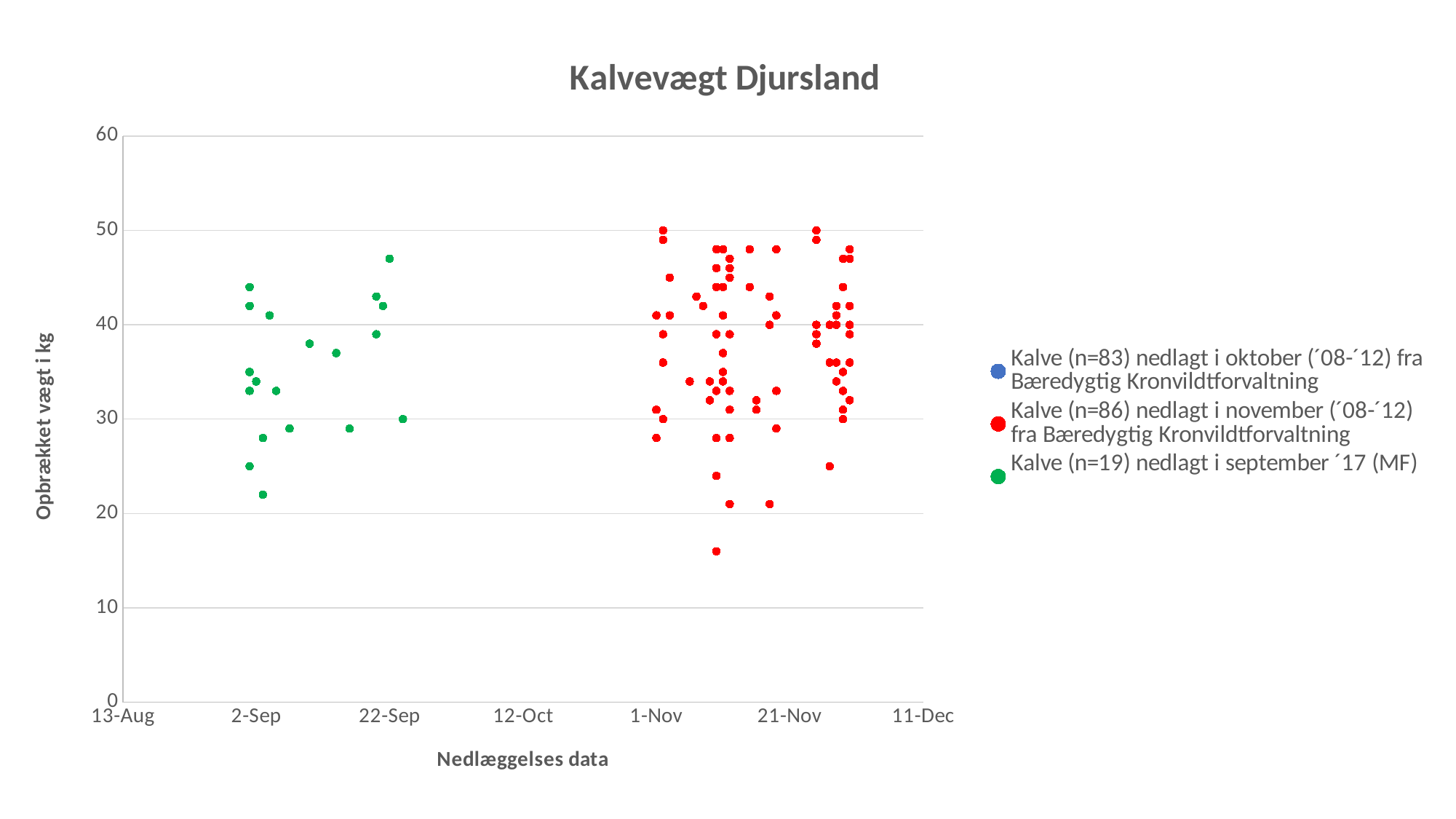
Is the lowest red (November) point greater or less than 20? less What is the label of the vertical axis? Opbrækket vægt i kg Is the lowest green (September '17) point greater or less than 20? greater What is the highest value shown on the vertical axis? 60 Which series reaches the higher maximum weight, the red November series or the green September '17 series? Red November series Is the highest green (September '17) point greater or less than 50? less How many series does the legend list? 3 According to the legend, how many calves (n) are in the November series? 86 What is the title of the chart? Kalvevægt Djursland What kind of chart is shown on the slide? Scatter chart According to the legend, how many calves (n) are in the September '17 series? 19